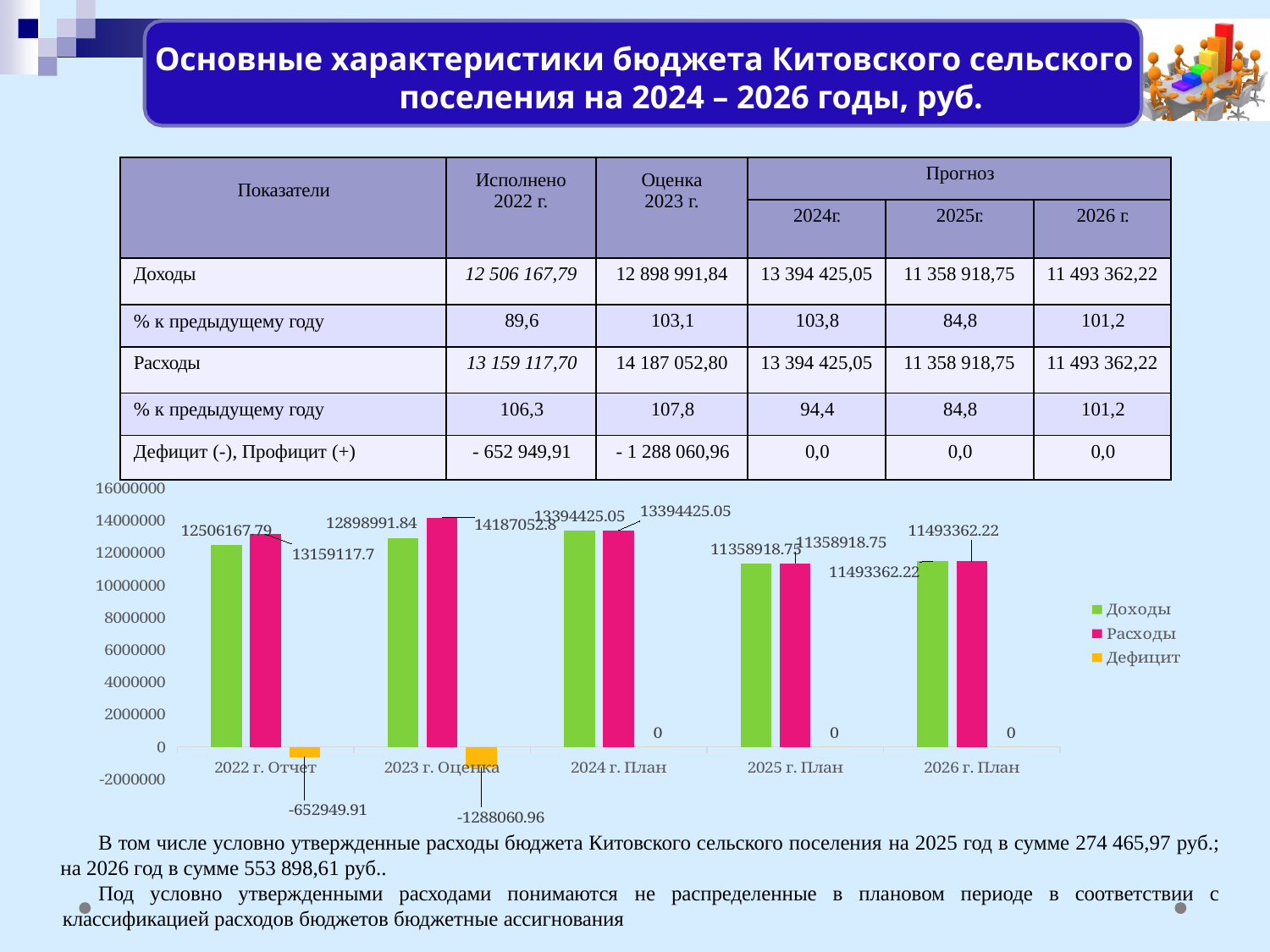
Which is larger in the chart for 2022 г. Отчет: Доходы or Расходы? Расходы Which series in the chart legend is shown in green? Доходы How many series does the chart legend list? 3 What is the difference between Расходы and Доходы for 2022 г. Отчет in the chart? 652949.91 What is the value of Доходы for 2022 г. Отчет in the chart? 12506167.79 What type of chart is shown on the slide? bar chart What is the value of Расходы for 2023 г. Оценка in the chart? 14187052.8 In which year category is Расходы highest in the chart? 2023 г. Оценка In which year category is Доходы lowest in the chart? 2025 г. План How many year categories are shown along the x axis of the chart? 5 What is the value of Дефицит for 2024 г. План in the chart? 0 What is the value of Дефицит for 2023 г. Оценка in the chart? -1288060.96